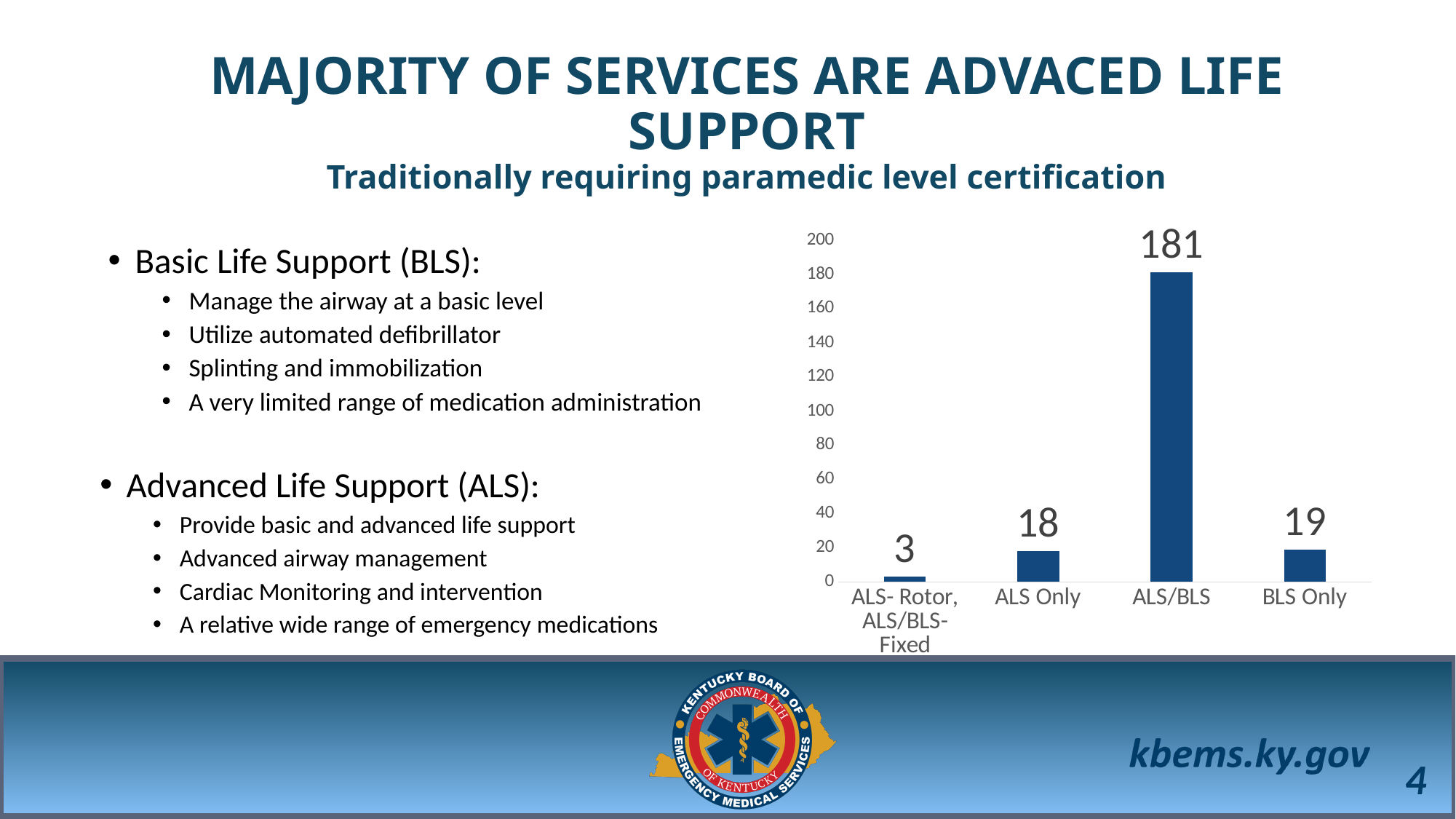
What is the difference between the values for ALS Only and ALS- Rotor, ALS/BLS-Fixed? 15 How many categories are shown on the x axis of the chart? 4 Is the value for ALS/BLS greater or less than 160? greater Which category has the lowest value? ALS- Rotor, ALS/BLS-Fixed Which is larger, the value for ALS/BLS or the value for ALS Only? ALS/BLS What is the difference between the values for ALS/BLS and BLS Only? 162 What kind of chart is shown on the slide? bar chart What is the value for ALS Only? 18 What is the value for BLS Only? 19 What is the value for ALS- Rotor, ALS/BLS-Fixed? 3 Which category has the highest value? ALS/BLS What is the value for ALS/BLS? 181